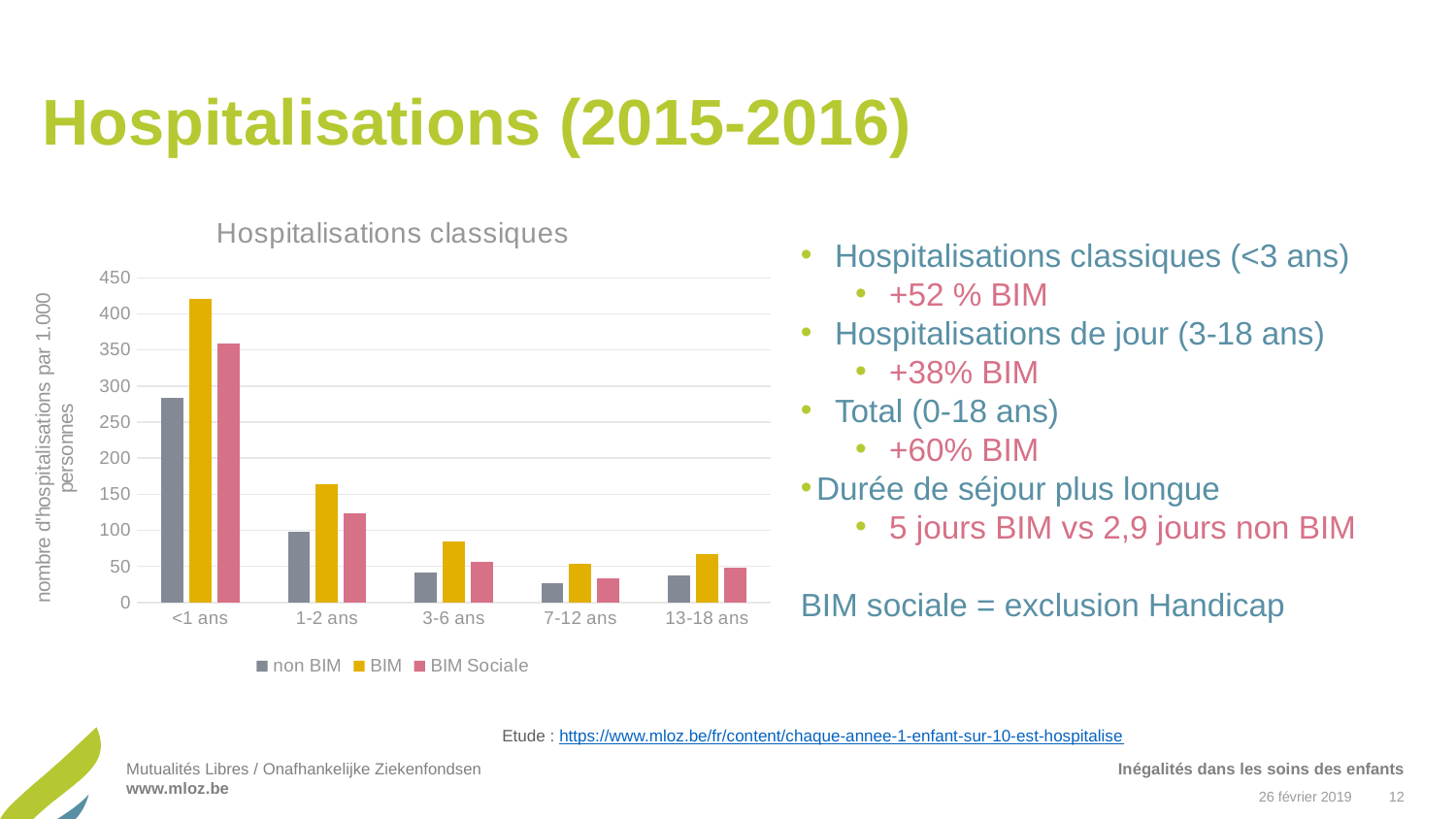
What kind of chart is shown on the slide? bar chart How many series does the chart legend list? 3 Is the BIM value for 1-2 ans greater or less than 150? greater How many age categories are shown on the x axis of the chart? 5 What is the title of the chart? Hospitalisations classiques Is the BIM value for <1 ans greater or less than 400? greater Which is larger for the 3-6 ans category, the BIM value or the BIM Sociale value? BIM Which series is shown in yellow in the chart? BIM Do the non BIM values generally rise or fall from <1 ans to 7-12 ans? fall Which age category has the lowest non BIM value? 7-12 ans Which age category has the highest BIM value? <1 ans